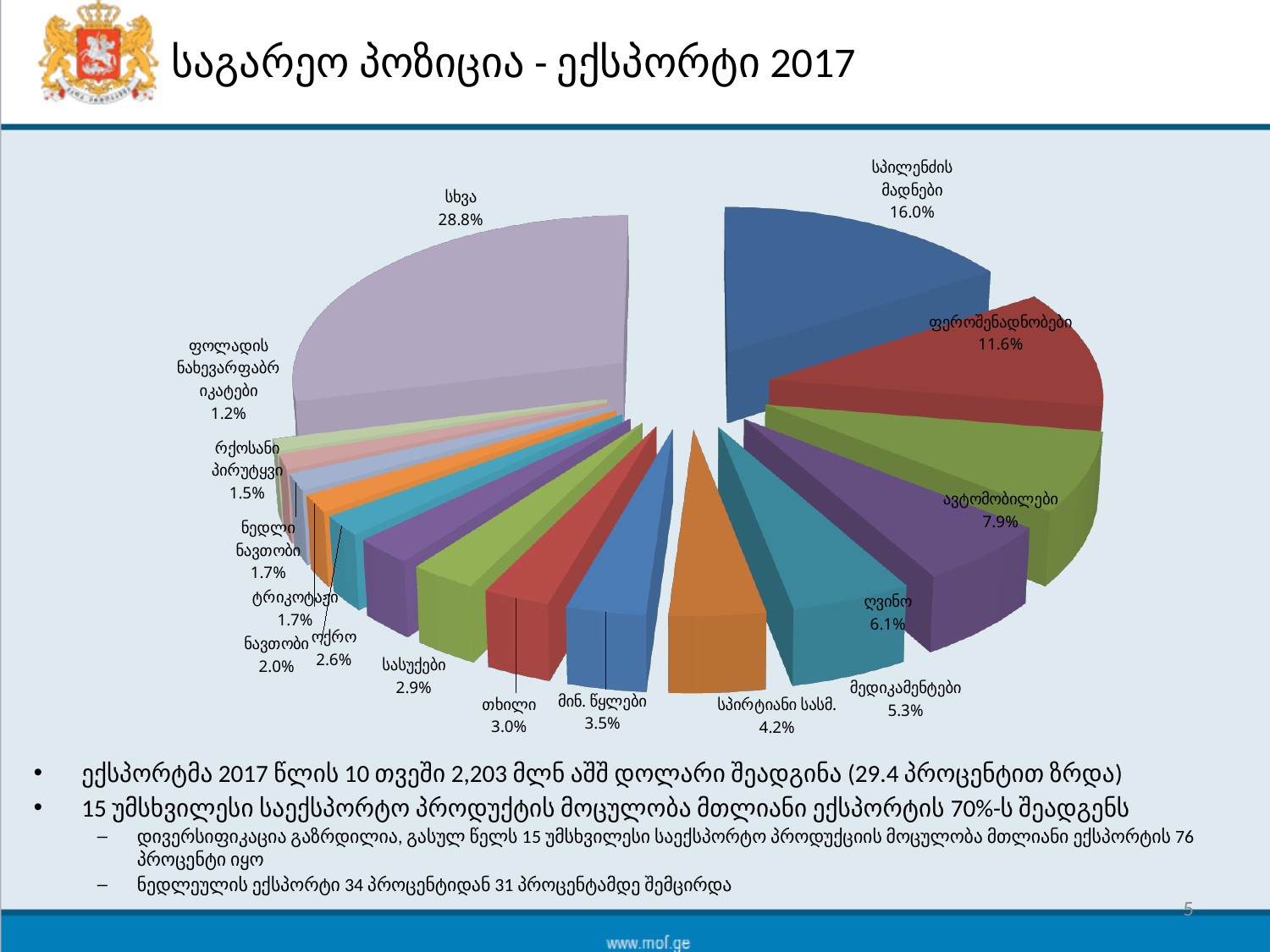
How many slices does the pie chart have? 16 What is the value shown for ღვინო (wine)? 6.1% What share of the pie does სპილენძის მადნები (copper ores) have? 16.0% What is the title of the slide containing the chart? საგარეო პოზიცია - ექსპორტი 2017 What is the value shown for სპირტიანი სასმ. (spirits)? 4.2% Which is larger, the share for ავტომობილები (cars) or the share for მედიკამენტები (medicines)? ავტომობილები What percentage is shown for ფეროშენადნობები (ferroalloys)? 11.6% Which slice of the pie is the smallest? ფოლადის ნახევარფაბრიკატები (1.2%) What kind of chart is shown on the slide? pie chart What is the difference in percentage points between სპილენძის მადნები (16.0%) and ფეროშენადნობები (11.6%)? 4.4 percentage points What percentage is labelled for სხვა (other)? 28.8% Which slice of the pie is the largest? სხვა (28.8%)